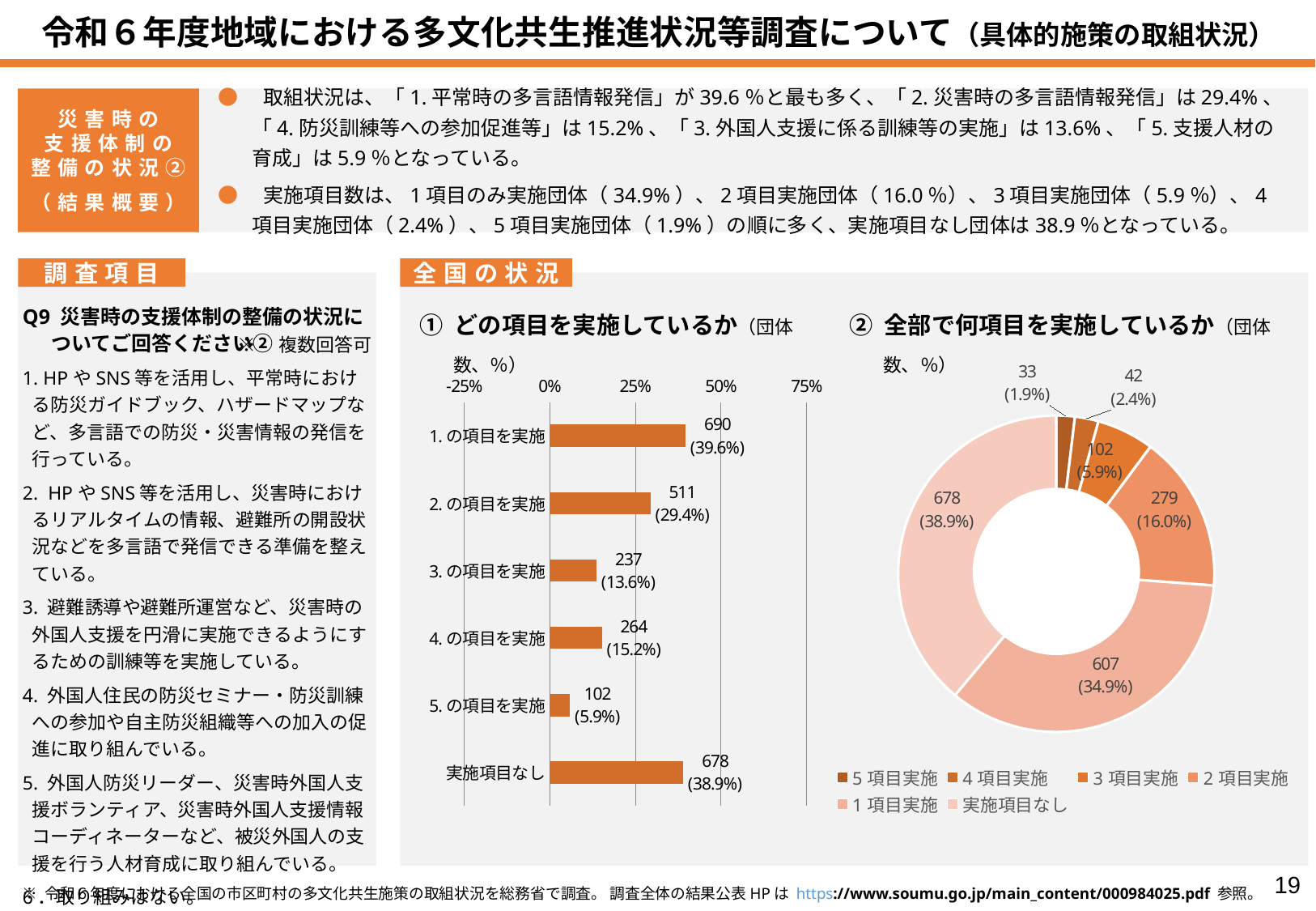
In the chart "① どの項目を実施しているか", what is the value for "1. の項目を実施"? 690 (39.6%) In the chart "② 全部で何項目を実施しているか", what share of the total does "1 項目実施" represent? 34.9% In the chart "② 全部で何項目を実施しているか", what is the value for "2 項目実施"? 279 (16.0%) What type of chart is "① どの項目を実施しているか"? Bar chart In the chart "① どの項目を実施しているか", which category has the highest value? 1. の項目を実施 In the chart "① どの項目を実施しているか", which is larger: "3. の項目を実施" or "4. の項目を実施"? 4. の項目を実施 In the chart "② 全部で何項目を実施しているか", which segment is the smallest? 5 項目実施 How many entries does the legend of the chart "② 全部で何項目を実施しているか" list? 6 In the chart "① どの項目を実施しているか", which category has the lowest value? 5. の項目を実施 In the chart "① どの項目を実施しているか", what is the difference between the values for "2. の項目を実施" and "3. の項目を実施"? 274 In the chart "① どの項目を実施しているか", what percentage is shown for "5. の項目を実施"? 5.9% In the chart "① どの項目を実施しているか", how many categories are plotted? 6